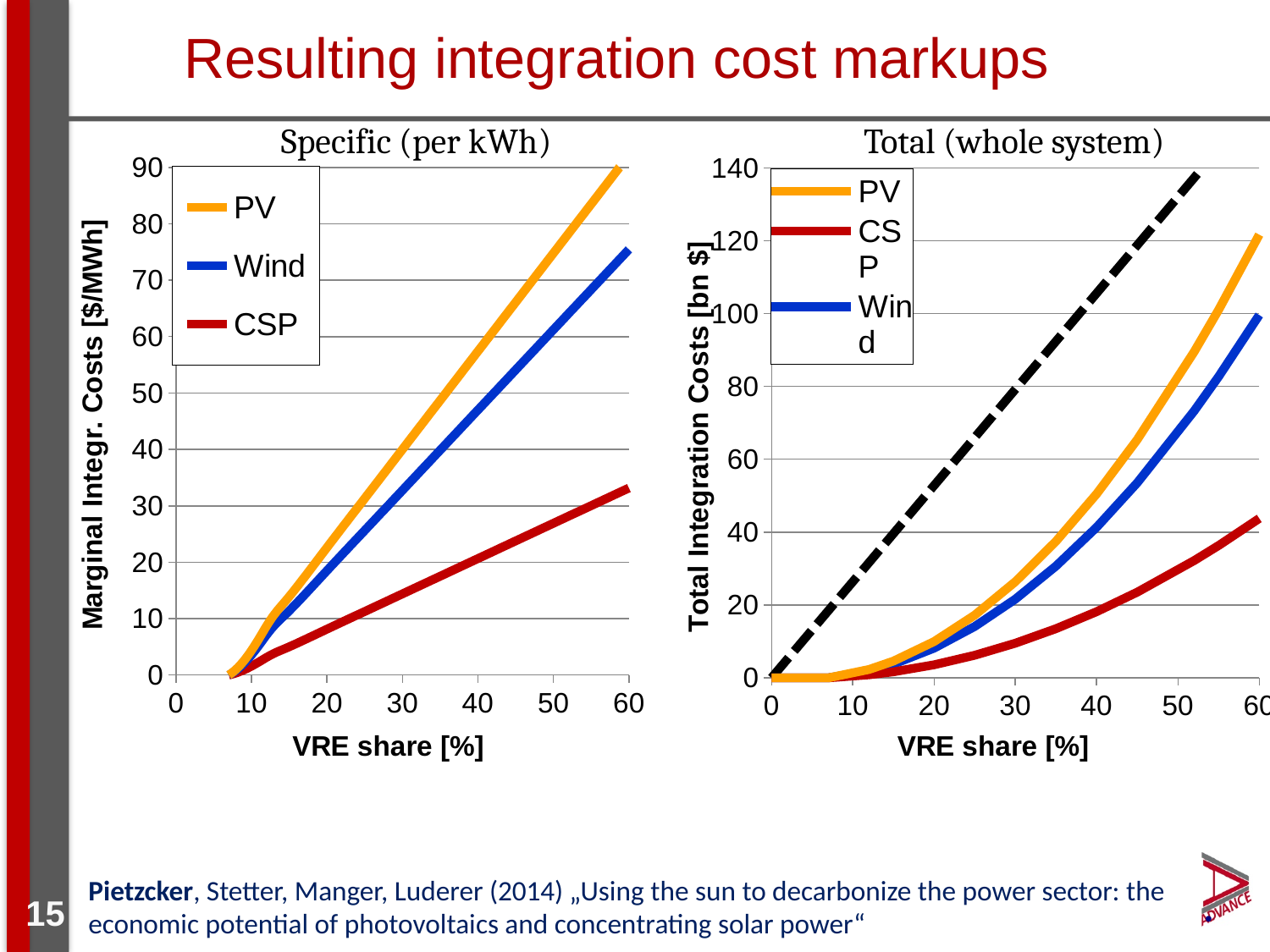
In the 'Total (whole system)' chart, is the CSP value at a VRE share of 60% greater or less than 60? less In the 'Specific (per kWh)' chart, is the PV value at a VRE share of 60% greater or less than 80? greater In the 'Total (whole system)' chart, do the PV costs rise or fall as VRE share increases? rise In the 'Total (whole system)' chart, which of the legend series has the lowest value at a VRE share of 60%? CSP In the 'Specific (per kWh)' chart, which series has the lowest value at a VRE share of 60%? CSP What kind of chart is the 'Specific (per kWh)' chart on the left? line chart In the 'Total (whole system)' chart, is the PV value at a VRE share of 60% greater or less than 100? greater How many series does the legend of the 'Total (whole system)' chart list? 3 In the 'Specific (per kWh)' chart, which is larger at a VRE share of 40%: PV or Wind? PV In the 'Specific (per kWh)' chart, which series has the highest value at a VRE share of 60%? PV How many series does the legend of the 'Specific (per kWh)' chart list? 3